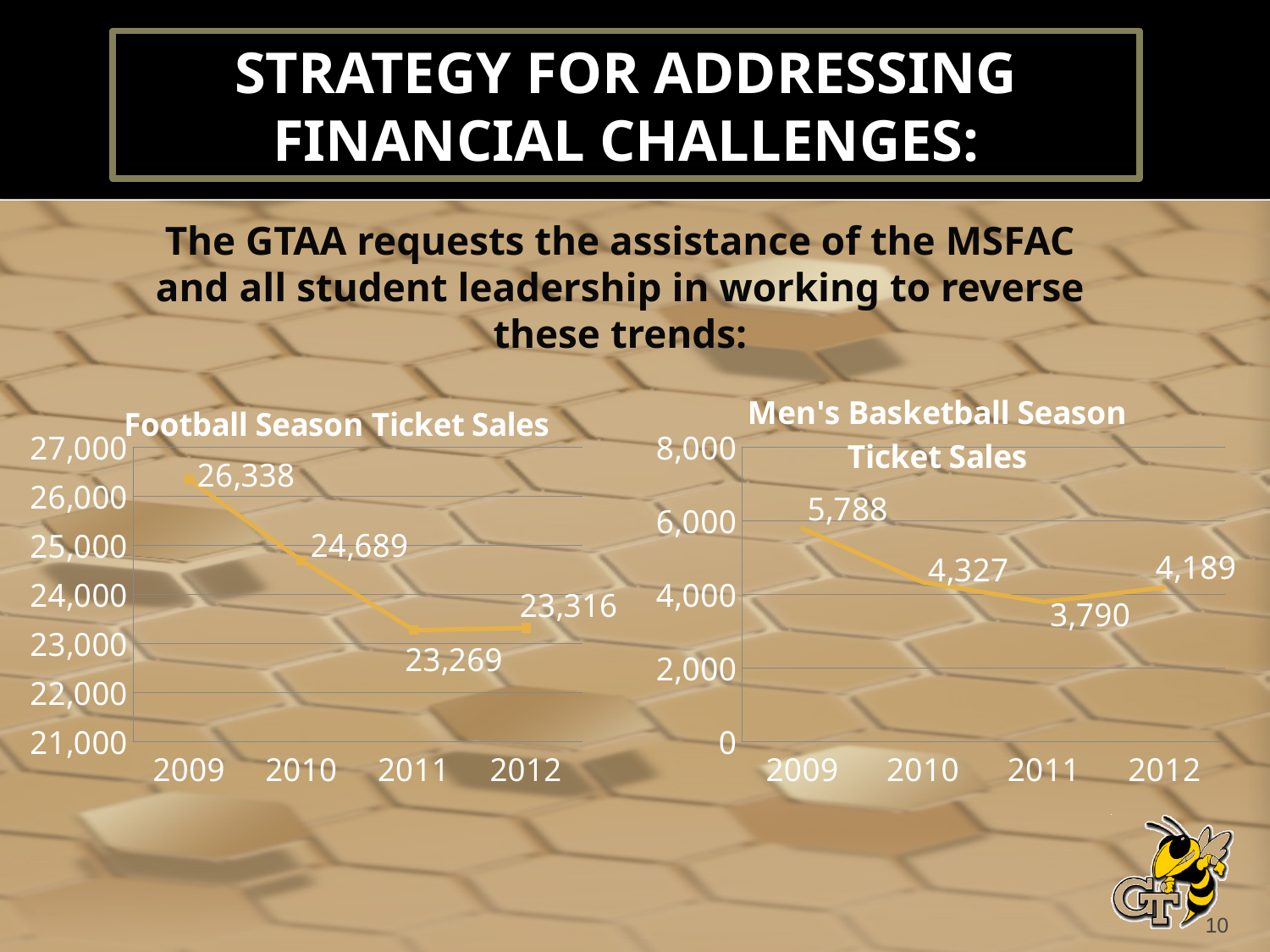
In the Football Season Ticket Sales chart, which year had the highest value? 2009 In the Football Season Ticket Sales chart, what is the difference between the 2009 and 2010 values? 1,649 In the Football Season Ticket Sales chart, do the values generally rise or fall from 2009 to 2012? Fall In the Men's Basketball Season Ticket Sales chart, what was the value for 2010? 4,327 In the Football Season Ticket Sales chart, what was the value for 2011? 23,269 In the Football Season Ticket Sales chart, what was the value for 2009? 26,338 In the Men's Basketball Season Ticket Sales chart, which year had the lowest value? 2011 In the Football Season Ticket Sales chart, which is larger, the value for 2011 or the value for 2012? 2012 In the Men's Basketball Season Ticket Sales chart, what was the value for 2012? 4,189 In the Men's Basketball Season Ticket Sales chart, what is the difference between the 2009 and 2011 values? 1,998 What kind of chart is the Football Season Ticket Sales chart? Line chart How many years are plotted in the Men's Basketball Season Ticket Sales chart? 4